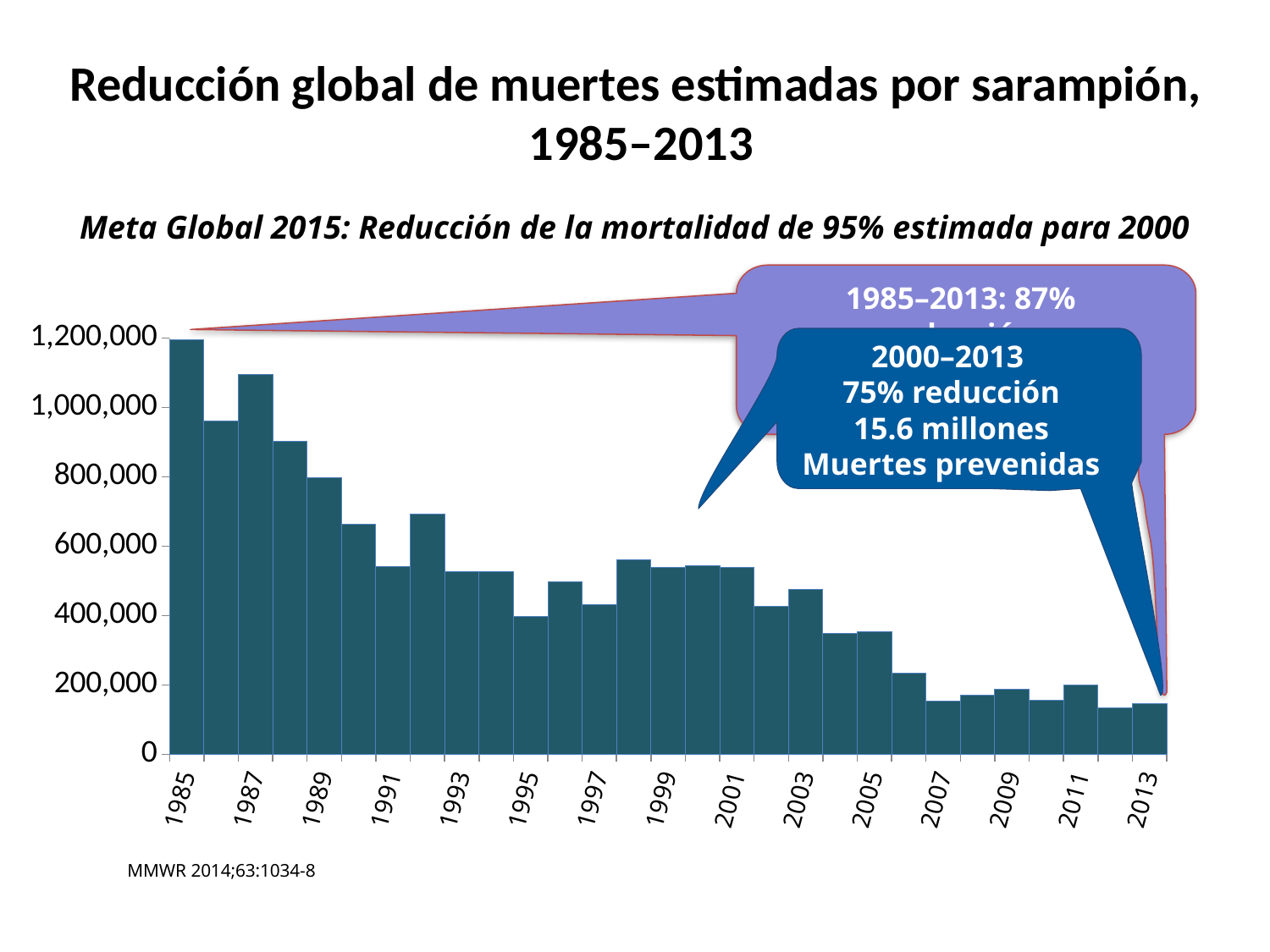
Is the value for 1987 greater or less than 1,000,000? greater According to the blue callout, what percentage reduction occurred between 2000 and 2013? 75% How many years (bars) are plotted in the chart? 29 Which is larger, the value for 1985 or the value for 2013? 1985 Is the value for 2004 greater or less than 400,000? less Do the values generally rise or fall from 1985 to 2013? fall Is the value for 2013 greater or less than 200,000? less Which is larger, the value for 1992 or the value for 1991? 1992 Which year has the highest estimated number of measles deaths? 1985 What kind of chart is shown on the slide? bar chart